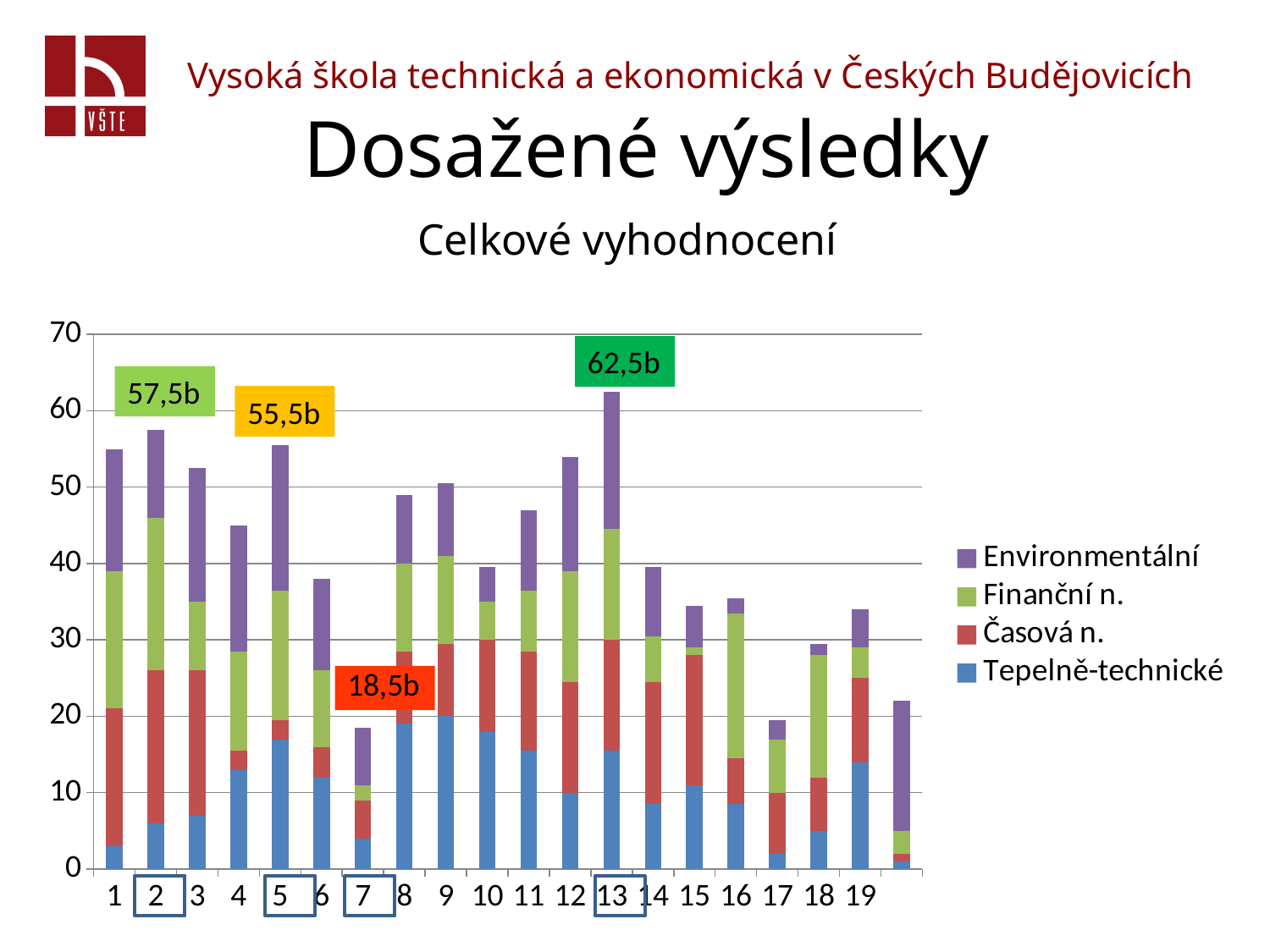
What is the total value labelled for bar 5? 55,5b Is the total for bar 15 greater or less than 40? less What is the difference between the labelled totals of bar 13 and bar 2? 5b What is the total value labelled for bar 7? 18,5b What is the total value labelled for bar 2? 57,5b What is the total value labelled for bar 13? 62,5b What kind of chart is shown? Stacked bar chart What is the difference between the labelled totals of bar 2 and bar 5? 2b Is the total for bar 4 greater or less than 50? less Which bar has the highest total? 13 How many series does the legend list? 4 Which has the larger total, bar 2 or bar 5? Bar 2